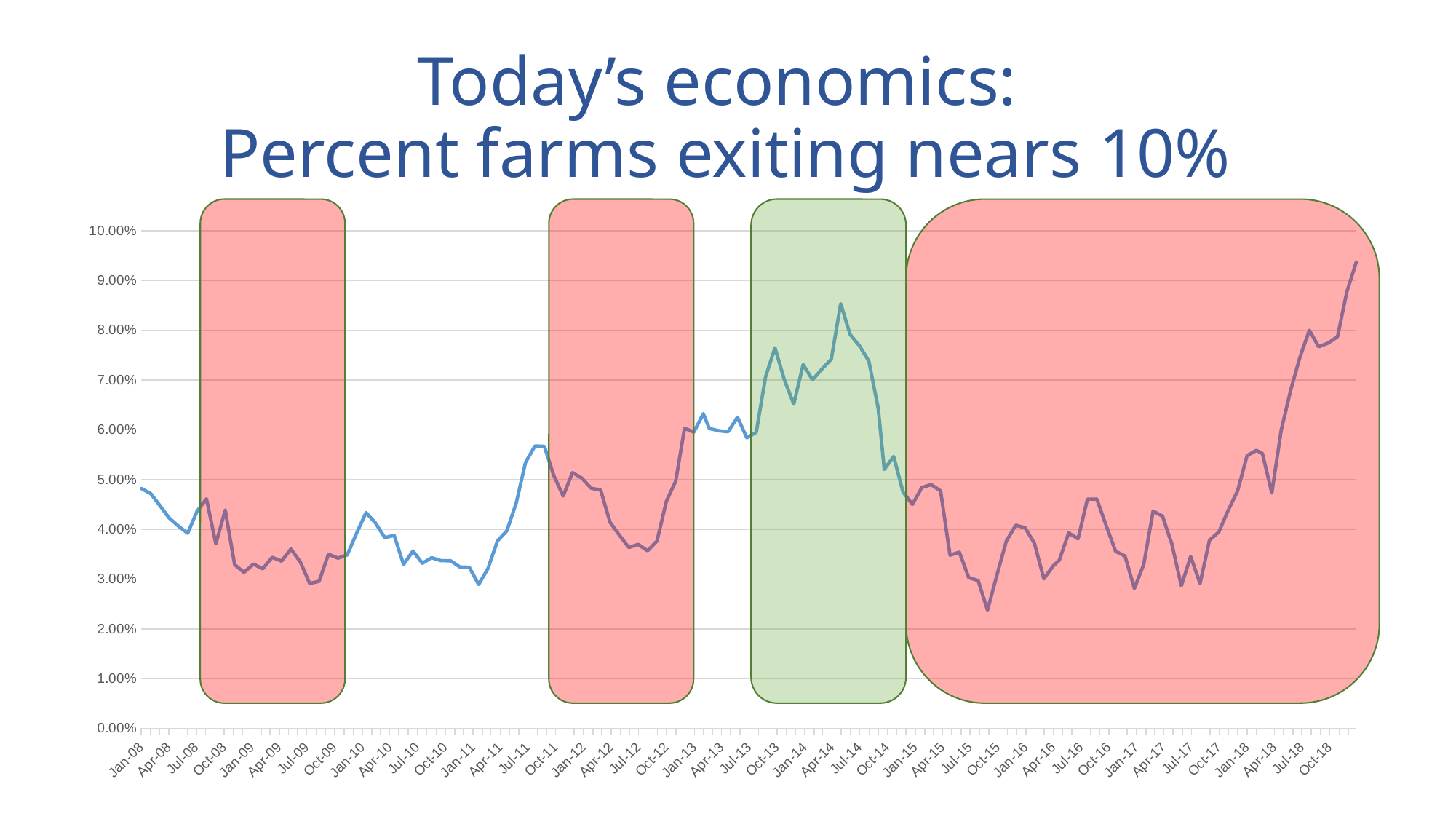
Is the value at Jul-11 greater or less than 5.00%? greater What is the title of the slide's chart? Today's economics: Percent farms exiting nears 10% Does the line reach its highest value at the start or at the end of the period shown? end Which is larger, the value at Jan-08 or the value at Jan-11? Jan-08 Is the value at Oct-15 greater or less than 3.00%? greater Between Jul-17 and the end of the series, does the line generally rise or fall? rise What kind of chart is shown on the slide? line chart Is the highest point inside the green shaded region greater or less than 8.00%? greater How many shaded rectangular regions are overlaid on the chart? 4